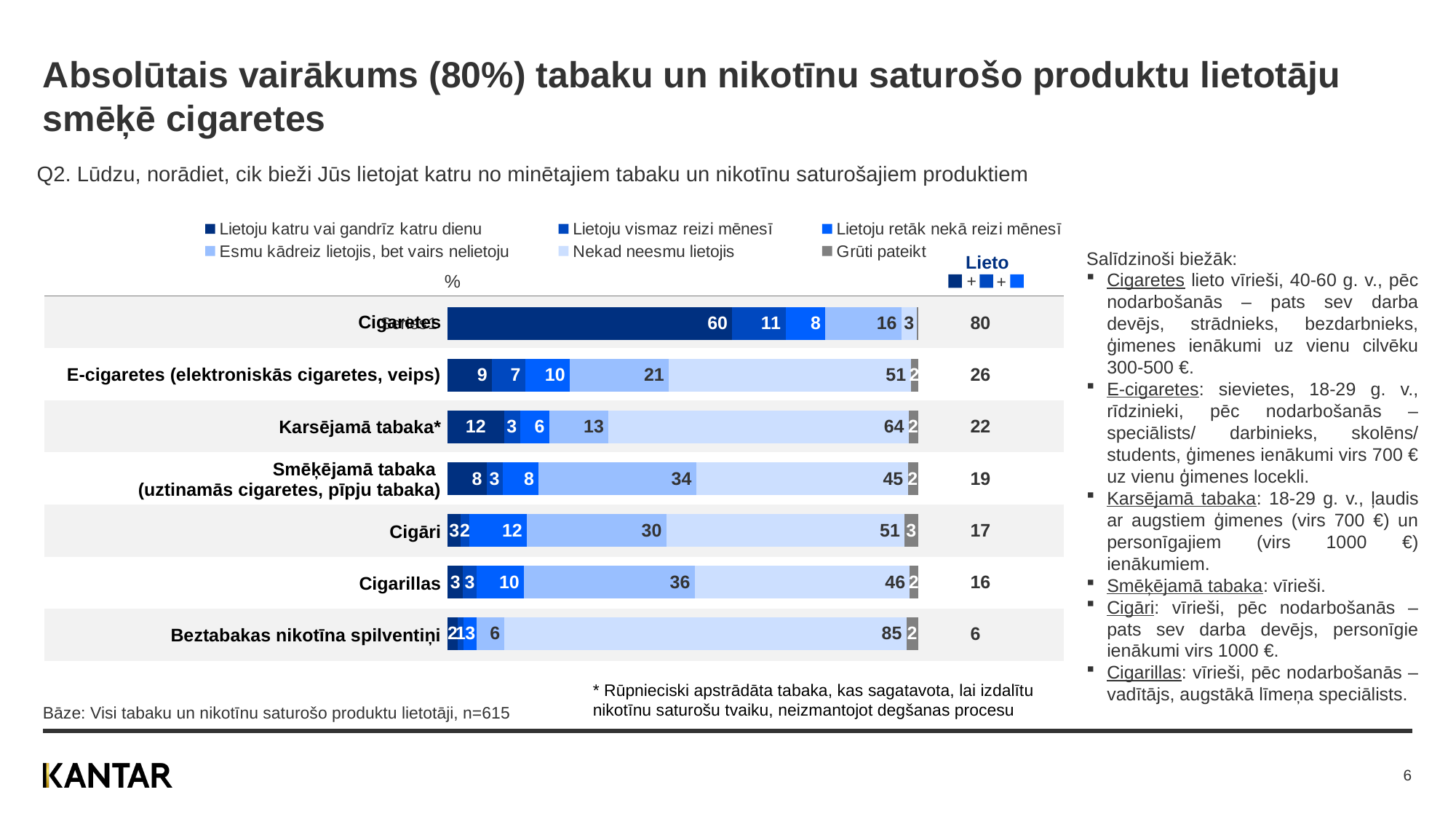
Which has a larger 'Nekad neesmu lietojis' value: E-cigaretes or Karsējamā tabaka*? Karsējamā tabaka* What is the heading of the summary column to the right of the bars? Lieto What kind of chart is shown on the slide? Stacked bar chart How many series does the chart legend list? 6 How many product categories are plotted in the chart? 7 What is the 'Lieto' value for Cigāri? 17 What is the value of 'Lietoju katru vai gandrīz katru dienu' for Cigaretes? 60 Which product has the lowest 'Lieto' value? Beztabakas nikotīna spilventiņi What is the value of 'Esmu kādreiz lietojis, bet vairs nelietoju' for Cigarillas? 36 What is the difference between the 'Lieto' values for Cigaretes and E-cigaretes? 54 Which product has the highest 'Lieto' value? Cigaretes What is the value of 'Nekad neesmu lietojis' for Beztabakas nikotīna spilventiņi? 85